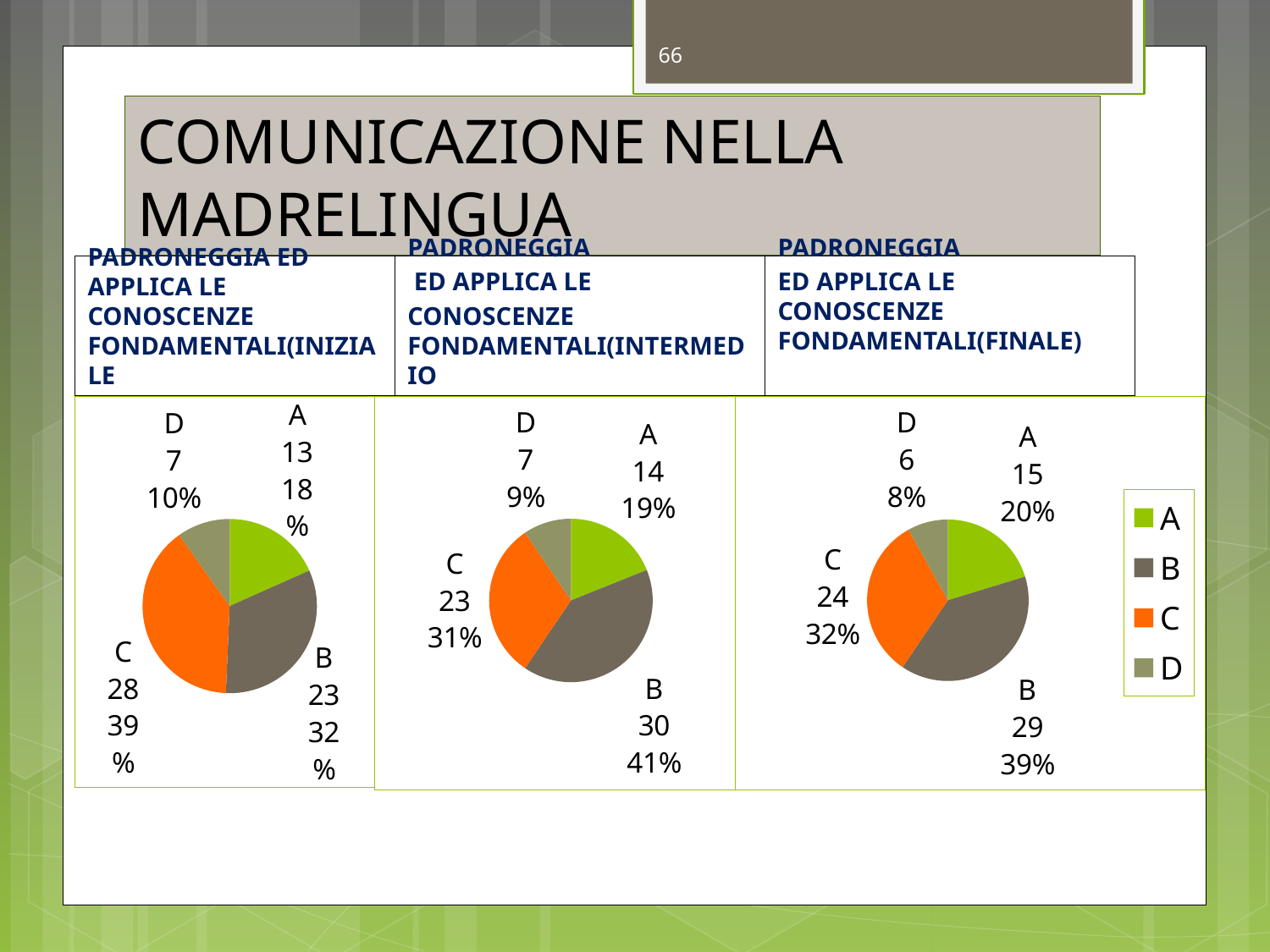
In the left pie chart (INIZIALE), which category has the smallest slice? D In the left pie chart (INIZIALE), what share of the pie does category B represent? 32% In the right pie chart (FINALE), which category has the largest slice? B In the middle pie chart (INTERMEDIO), what is the value for category B? 30 In the middle pie chart (INTERMEDIO), what is the difference between the values for B and C? 7 In the right pie chart (FINALE), what is the value for category A? 15 In the right pie chart (FINALE), which is larger, the value for C or the value for A? C In the left pie chart (INIZIALE), what is the value for category C? 28 What type of chart is used on this slide? Pie chart Which colour represents category C in the legend? Orange In the middle pie chart (INTERMEDIO), what share of the pie does category D represent? 9% How many categories does each pie chart show? 4